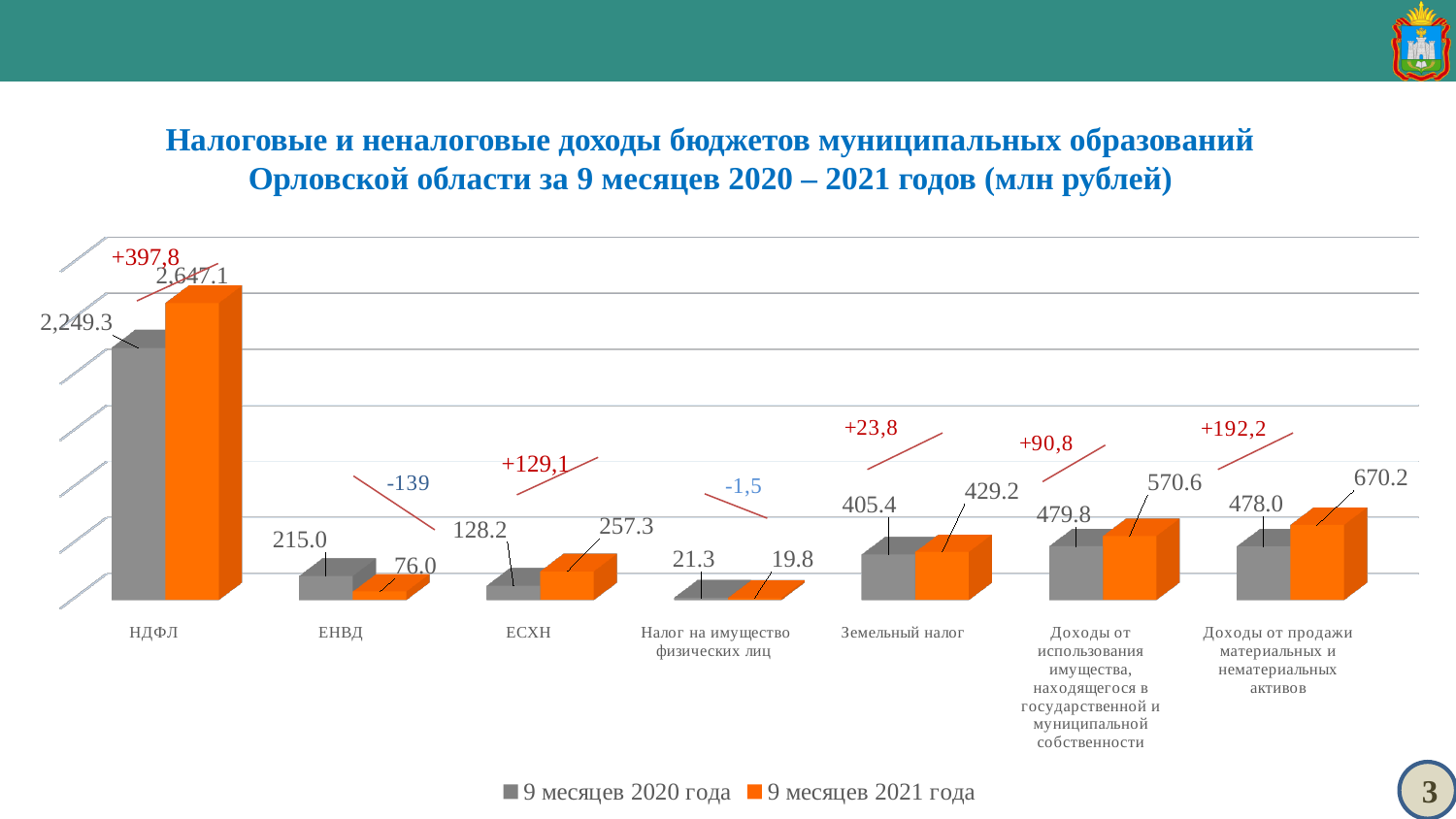
How many series does the legend list? 2 Which category has the lowest value in the series 9 месяцев 2020 года? Налог на имущество физических лиц How many categories are shown on the x axis of the chart? 7 Which category has the highest value in the series 9 месяцев 2021 года? НДФЛ Which colour represents the series 9 месяцев 2021 года? Orange What kind of chart is shown on the slide? Bar chart What is the value for ЕНВД in the series 9 месяцев 2020 года? 215.0 What is the value for Налог на имущество физических лиц in the series 9 месяцев 2020 года? 21.3 Which is larger for ЕНВД: the value for 9 месяцев 2020 года or for 9 месяцев 2021 года? 9 месяцев 2020 года What is the difference between the 9 месяцев 2021 года and 9 месяцев 2020 года values for ЕСХН? 129.1 What is the value for НДФЛ in the series 9 месяцев 2021 года? 2,647.1 What is the value for Земельный налог in the series 9 месяцев 2021 года? 429.2